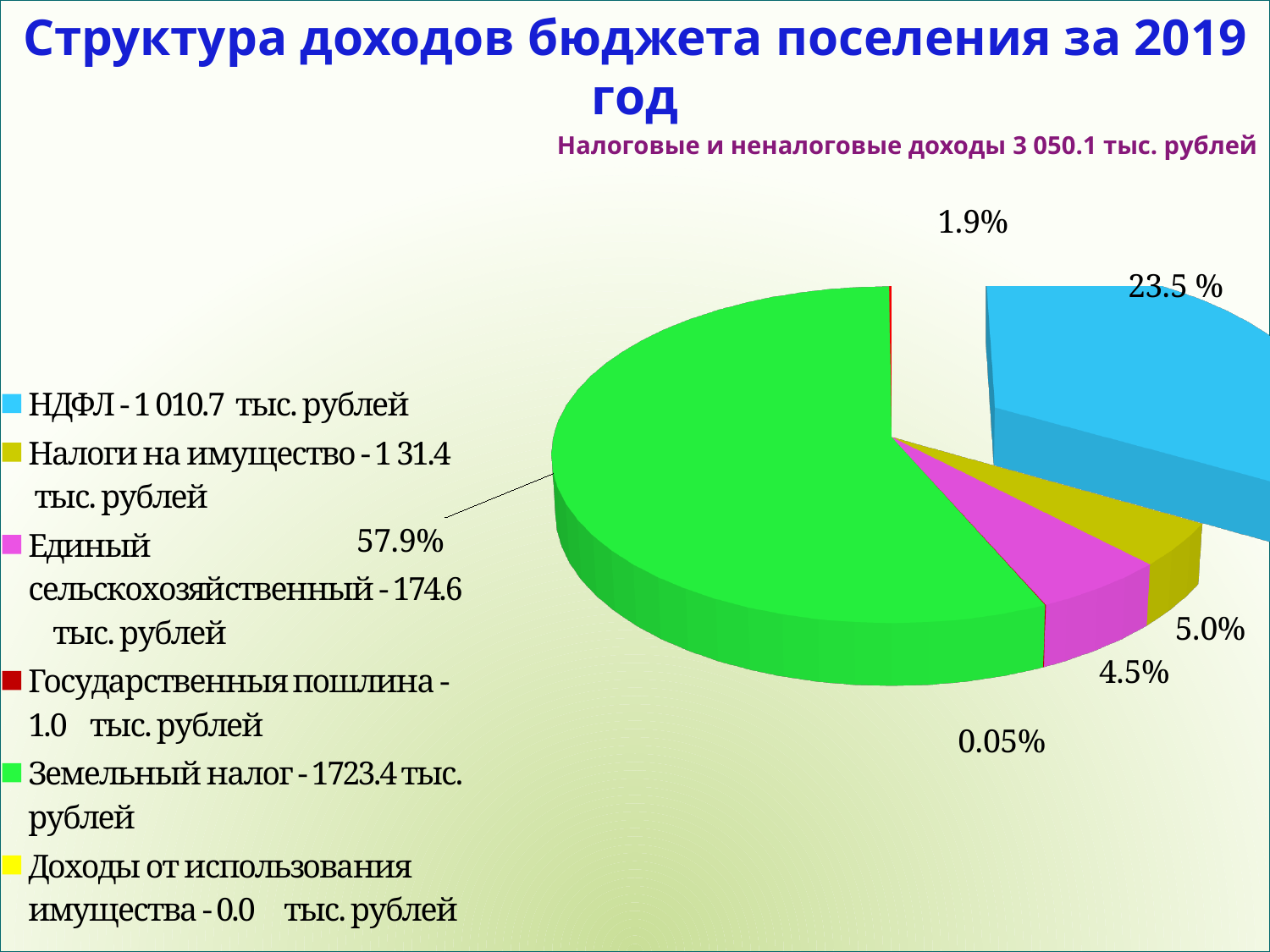
What amount in тыс. рублей does the legend give for Государственная пошлина? 1.0 тыс. рублей What kind of chart is shown on the slide? pie chart What amount in тыс. рублей does the legend give for НДФЛ? 1 010.7 тыс. рублей What amount in тыс. рублей does the legend give for Земельный налог? 1723.4 тыс. рублей How many entries does the legend of the pie chart list? 6 What percentage share is labelled on the green slice (Земельный налог)? 57.9% What is the title of the slide? Структура доходов бюджета поселения за 2019 год Which category has the largest slice of the pie chart? Земельный налог Which is larger according to the legend: НДФЛ or Единый сельскохозяйственный налог? НДФЛ What amount in тыс. рублей does the legend give for Единый сельскохозяйственный налог? 174.6 тыс. рублей What total of tax and non-tax revenues is stated in the subtitle above the chart? 3 050.1 тыс. рублей What percentage share is labelled on the blue slice (НДФЛ)? 23.5 %